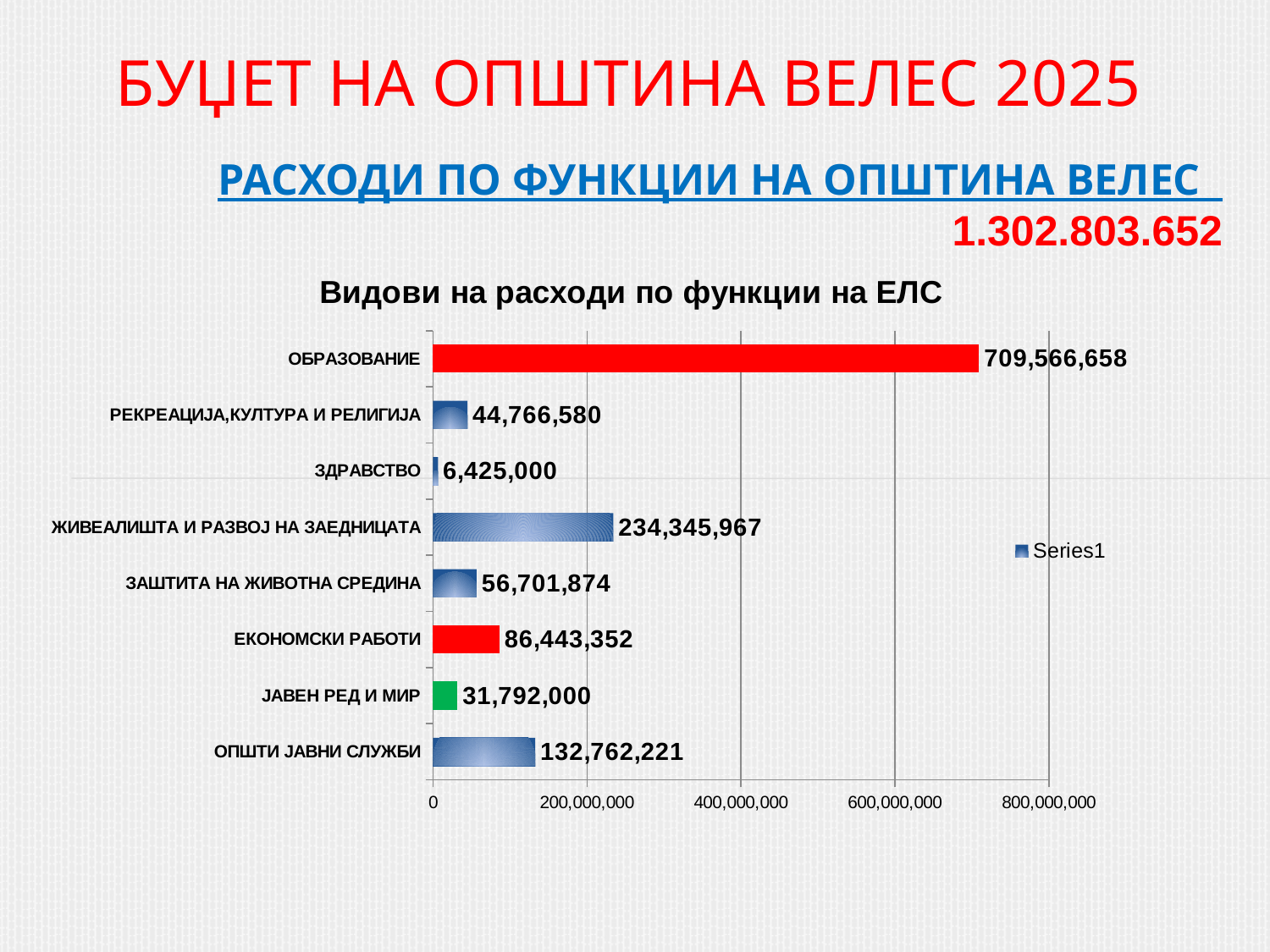
What is the value for ЖИВЕАЛИШТА И РАЗВОЈ НА ЗАЕДНИЦАТА? 234,345,967 What kind of chart is shown on the slide? Bar chart Which category has the highest value in the chart? ОБРАЗОВАНИЕ What is the value for ОПШТИ ЈАВНИ СЛУЖБИ? 132,762,221 What is the value for ОБРАЗОВАНИЕ in the chart? 709,566,658 What is the value for ЈАВЕН РЕД И МИР? 31,792,000 What is the title of the chart? Видови на расходи по функции на ЕЛС Which category has the lowest value in the chart? ЗДРАВСТВО What is the difference between the values for ОПШТИ ЈАВНИ СЛУЖБИ and ЕКОНОМСКИ РАБОТИ? 46,318,869 Which is larger, the value for ЗАШТИТА НА ЖИВОТНА СРЕДИНА or the value for РЕКРЕАЦИЈА,КУЛТУРА И РЕЛИГИЈА? ЗАШТИТА НА ЖИВОТНА СРЕДИНА How many categories are shown in the chart? 8 What is the difference between the values for ОБРАЗОВАНИЕ and ЖИВЕАЛИШТА И РАЗВОЈ НА ЗАЕДНИЦАТА? 475,220,691